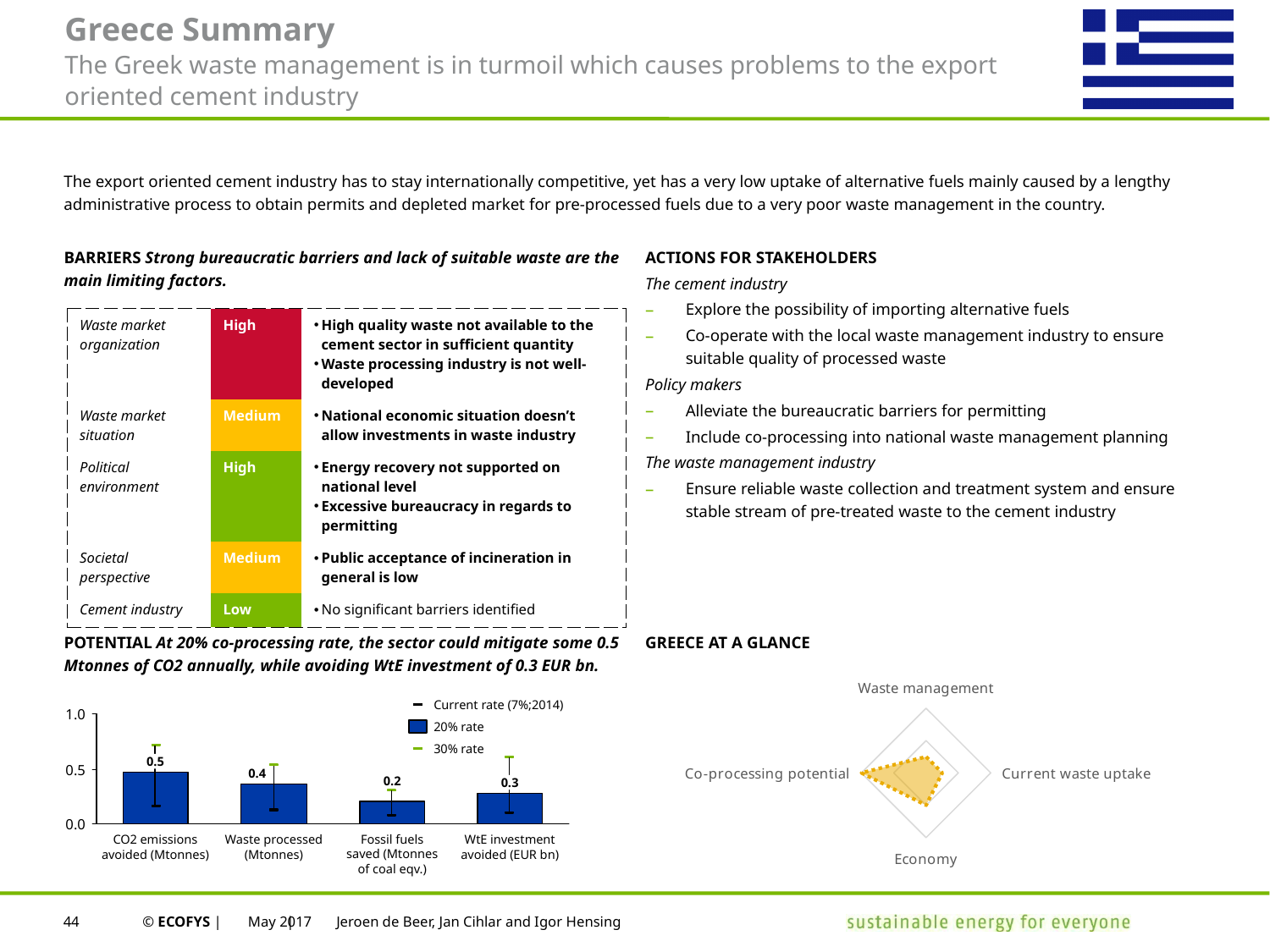
In the bar chart at the bottom left, what is the difference between the 20% rate values for CO2 emissions avoided and Fossil fuels saved? 0.3 In the bar chart at the bottom left, how many entries does the legend list? 3 In the bar chart at the bottom left, what is the value for Fossil fuels saved (Mtonnes of coal eqv.) at the 20% rate? 0.2 In the bar chart at the bottom left, what is the value for Waste processed (Mtonnes) at the 20% rate? 0.4 In the bar chart at the bottom left, which category has the highest 20% rate bar? CO2 emissions avoided (Mtonnes) In the bar chart at the bottom left, which category has the lowest 20% rate bar? Fossil fuels saved (Mtonnes of coal eqv.) In the bar chart at the bottom left, what is the value for WtE investment avoided (EUR bn) at the 20% rate? 0.3 In the chart under 'GREECE AT A GLANCE', how many axes are labelled? 4 What kind of chart is shown at the bottom left of the slide? Bar chart In the bar chart at the bottom left, what is the value for CO2 emissions avoided (Mtonnes) at the 20% rate? 0.5 In the bar chart at the bottom left, which is larger at the 20% rate: Waste processed or WtE investment avoided? Waste processed In the bar chart at the bottom left, how many categories are shown on the x axis? 4